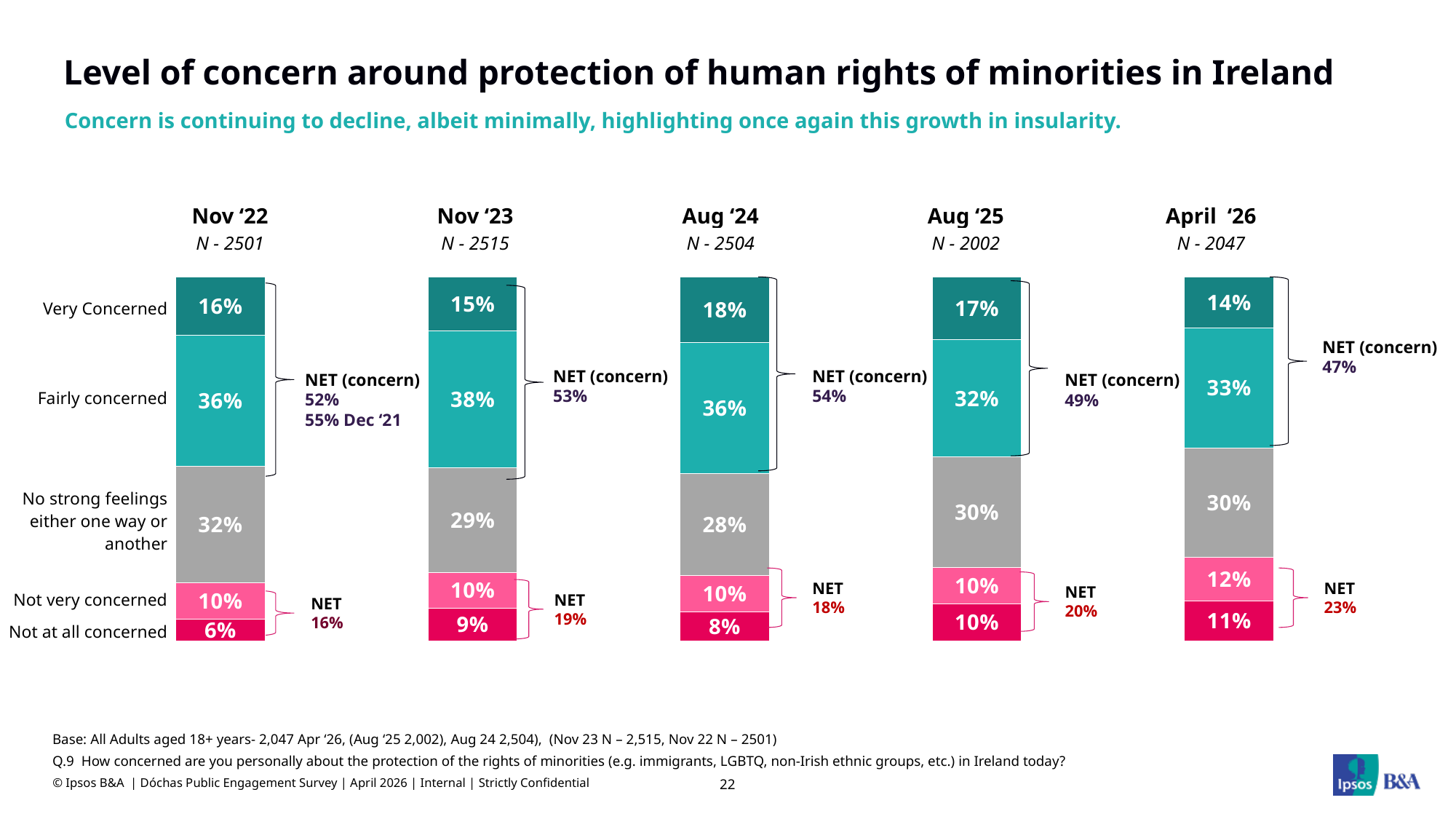
How many survey waves are shown in the chart? 5 What percentage of respondents were Very Concerned in April '26? 14% What is the NET (concern) figure for Aug '24? 54% In which wave is the Not at all concerned share lowest? Nov '22 What is the difference between the NET (concern) figures for Nov '22 and April '26? 5 percentage points Does the NET (concern) figure rise or fall from Aug '24 to April '26? Fall What is the sample size (N) for the Aug '25 wave? 2002 What type of chart is used on this slide? Stacked bar chart Which is larger: the Fairly concerned share in Aug '24 or in Aug '25? Aug '24 What percentage of respondents were Fairly concerned in Nov '23? 38% In which wave is the NET (concern) figure highest? Aug '24 What is the NET figure for the not concerned responses in April '26? 23%